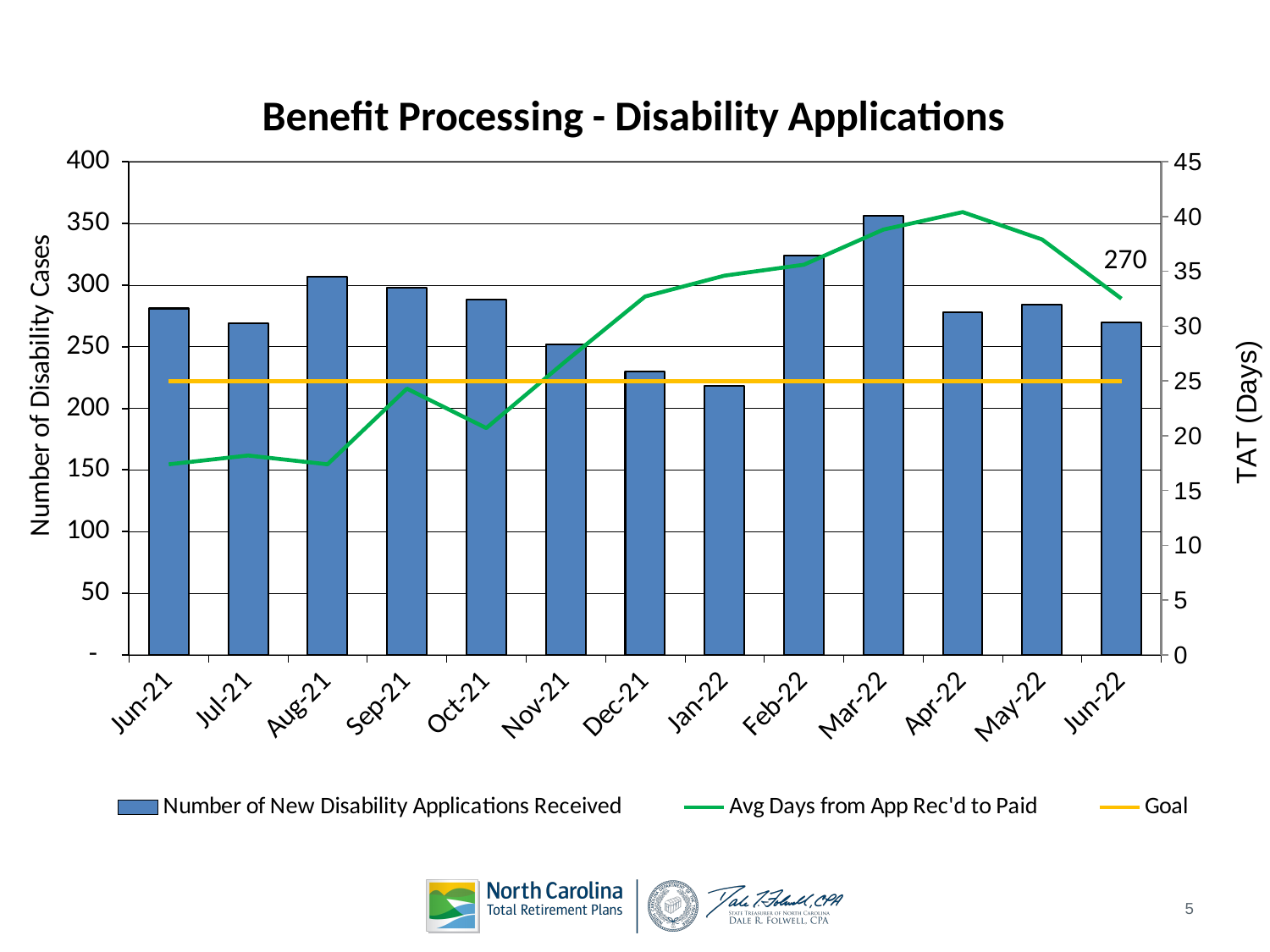
How many months are shown on the x axis? 13 Does the average days from application received to paid rise or fall from Apr-22 to Jun-22? fall Which month has the lowest number of new disability applications received? Jan-22 How many series does the legend list? 3 What is the number of new disability applications received in Jun-22? 270 Is the number of new disability applications received in Feb-22 greater or less than 300? greater Is the average days from application received to paid in Jun-21 greater or less than 20? less Is the number of new disability applications received in Jan-22 greater or less than 250? less Which month has the highest number of new disability applications received? Mar-22 Which month has more new disability applications received, Jul-21 or Aug-21? Aug-21 What kind of chart is this? Combined bar and line chart